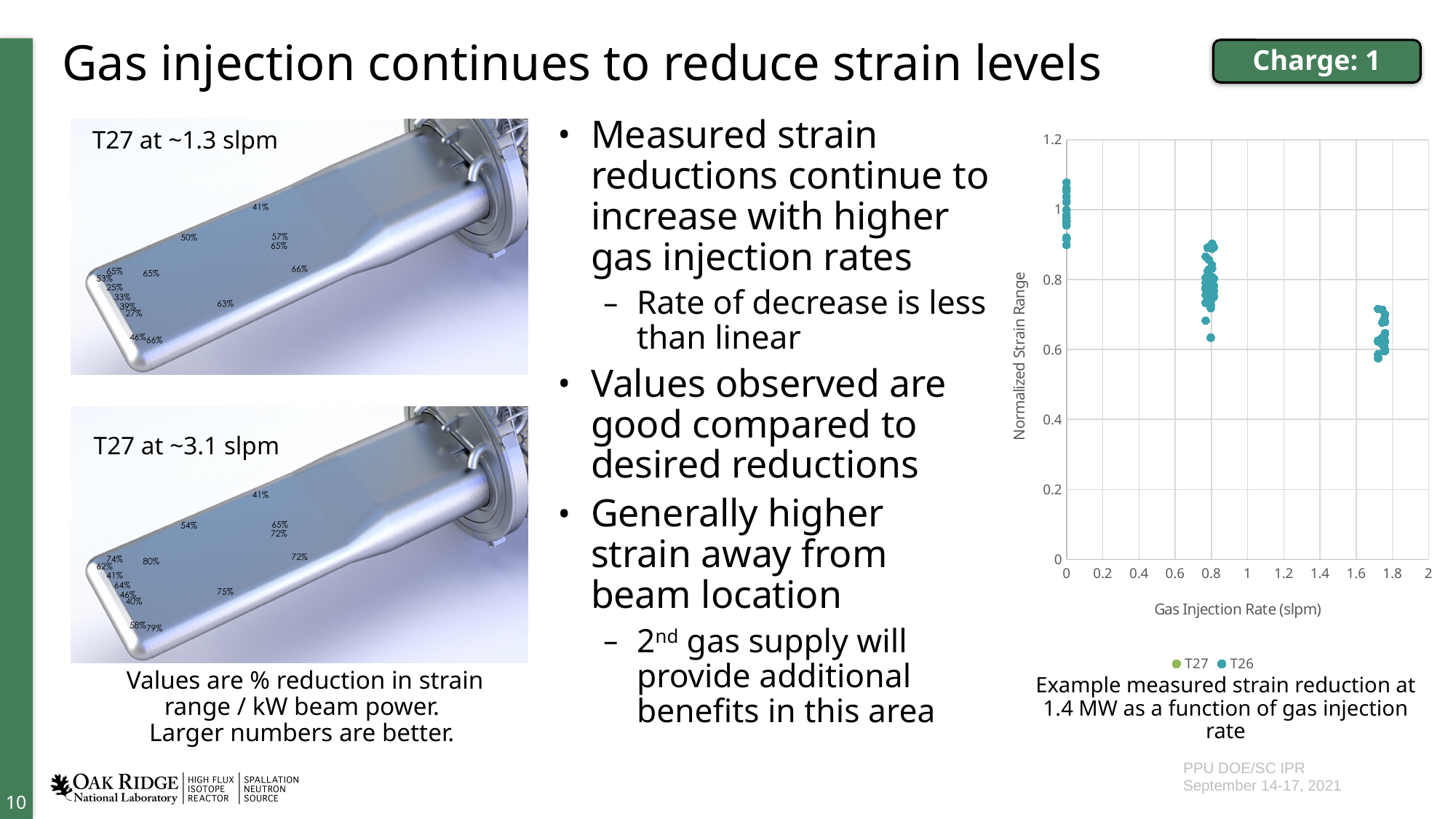
As the gas injection rate increases along the x axis, do the normalized strain range values rise or fall? fall What kind of chart is shown on the right side of the slide? scatter chart Which cluster of points has the highest normalized strain range: the one at 0 slpm, near 0.8 slpm, or near 1.8 slpm? 0 slpm Are the normalized strain range values plotted at a gas injection rate of 0 slpm greater or less than 0.8? greater Are the normalized strain range values plotted near a gas injection rate of 1.8 slpm greater or less than 0.4? greater What are the two series named in the legend of the chart? T27 and T26 What is the title of the x axis of the chart? Gas Injection Rate (slpm) Which cluster of points has the lowest normalized strain range: the one at 0 slpm, near 0.8 slpm, or near 1.8 slpm? near 1.8 slpm At how many distinct gas injection rates are data points clustered in the chart? 3 How many series does the legend of the strain reduction chart list? 2 Are the normalized strain range values plotted near a gas injection rate of 1.8 slpm greater or less than 0.8? less